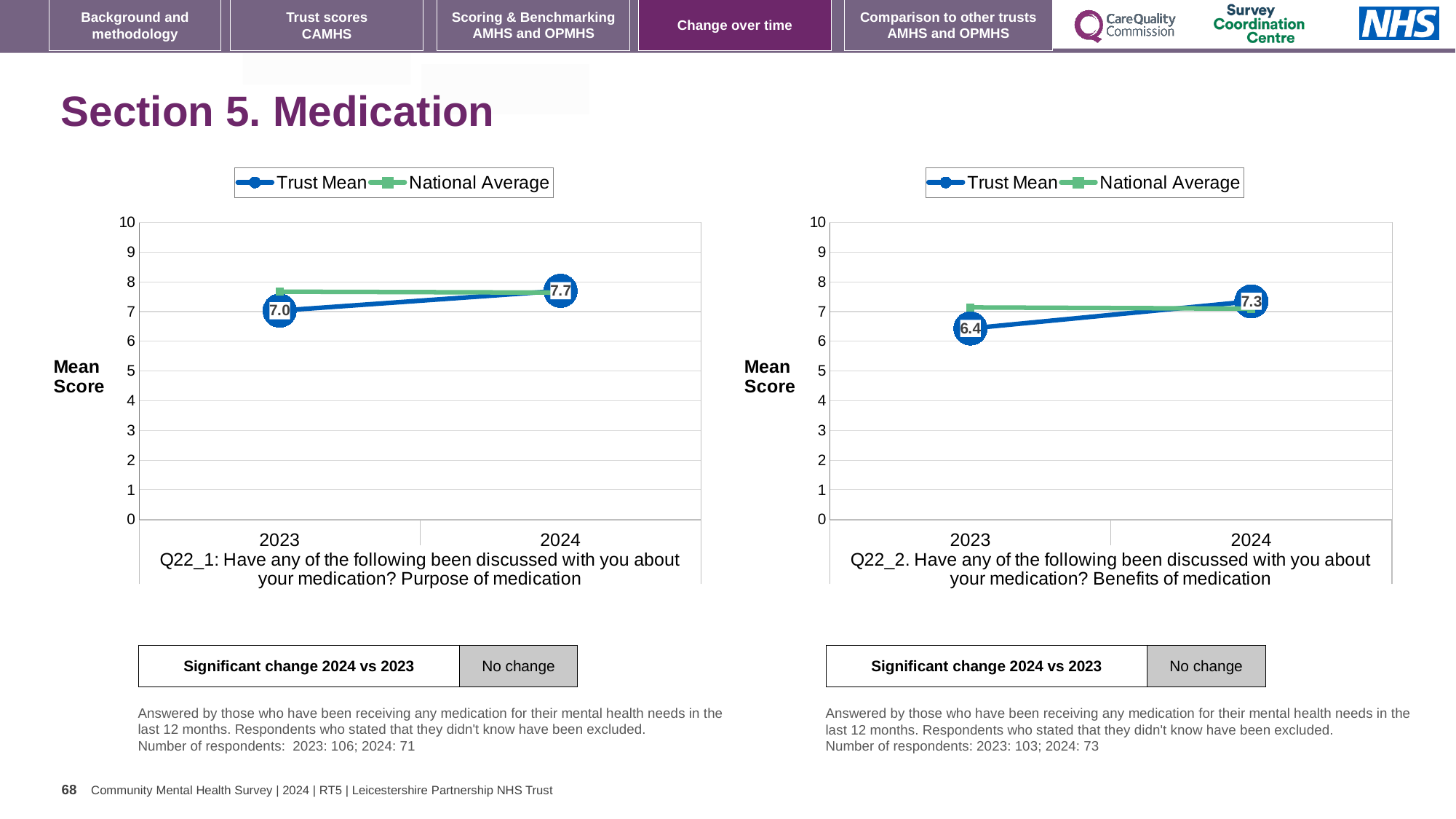
How many series does the legend of the left chart (Q22_1) list? 2 In the left chart (Q22_1), is the National Average for 2023 greater or less than 7? greater What kind of chart is the right chart (Q22_2: Benefits of medication)? line chart In the right chart (Q22_2: Benefits of medication), what is the Trust Mean for 2023? 6.4 In the left chart (Q22_1), by how much did the Trust Mean change from 2023 to 2024? 0.7 In the right chart (Q22_2), does the Trust Mean rise or fall from 2023 to 2024? rise In the left chart (Q22_1: Purpose of medication), what is the Trust Mean for 2023? 7.0 In the right chart (Q22_2), is the National Average for 2023 greater or less than 8? less In the left chart (Q22_1), in 2023, which is higher: the Trust Mean or the National Average? National Average In the left chart (Q22_1: Purpose of medication), what is the Trust Mean for 2024? 7.7 In the right chart (Q22_2: Benefits of medication), what is the Trust Mean for 2024? 7.3 In the right chart (Q22_2), what is the difference between the Trust Mean in 2024 and in 2023? 0.9